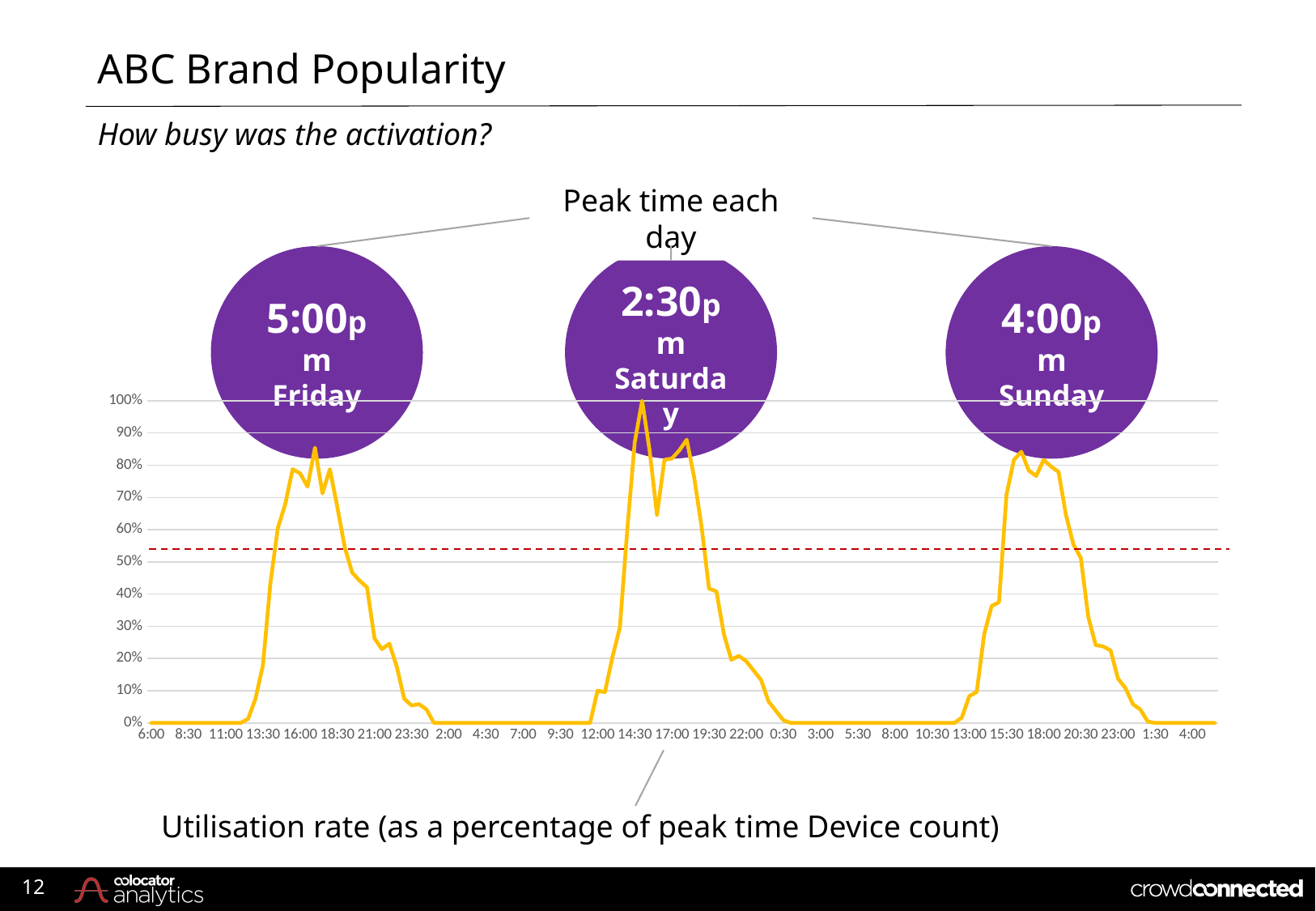
Is the Friday peak utilisation rate greater or less than 80%? greater What does the y-axis of the chart measure? Utilisation rate (as a percentage of peak time Device count) What utilisation rate does the Saturday peak reach? 100% What kind of chart is shown on the slide? line chart What colour is the plotted utilisation line? yellow What was the peak time on Saturday? 2:30pm What was the peak time on Sunday? 4:00pm Is the Sunday peak utilisation rate greater or less than 70%? greater What is the utilisation rate at 8:30 on the first day? 0% Is the level of the red dashed horizontal line greater or less than 50%? greater Which day reached the highest utilisation rate? Saturday What was the peak time on Friday? 5:00pm